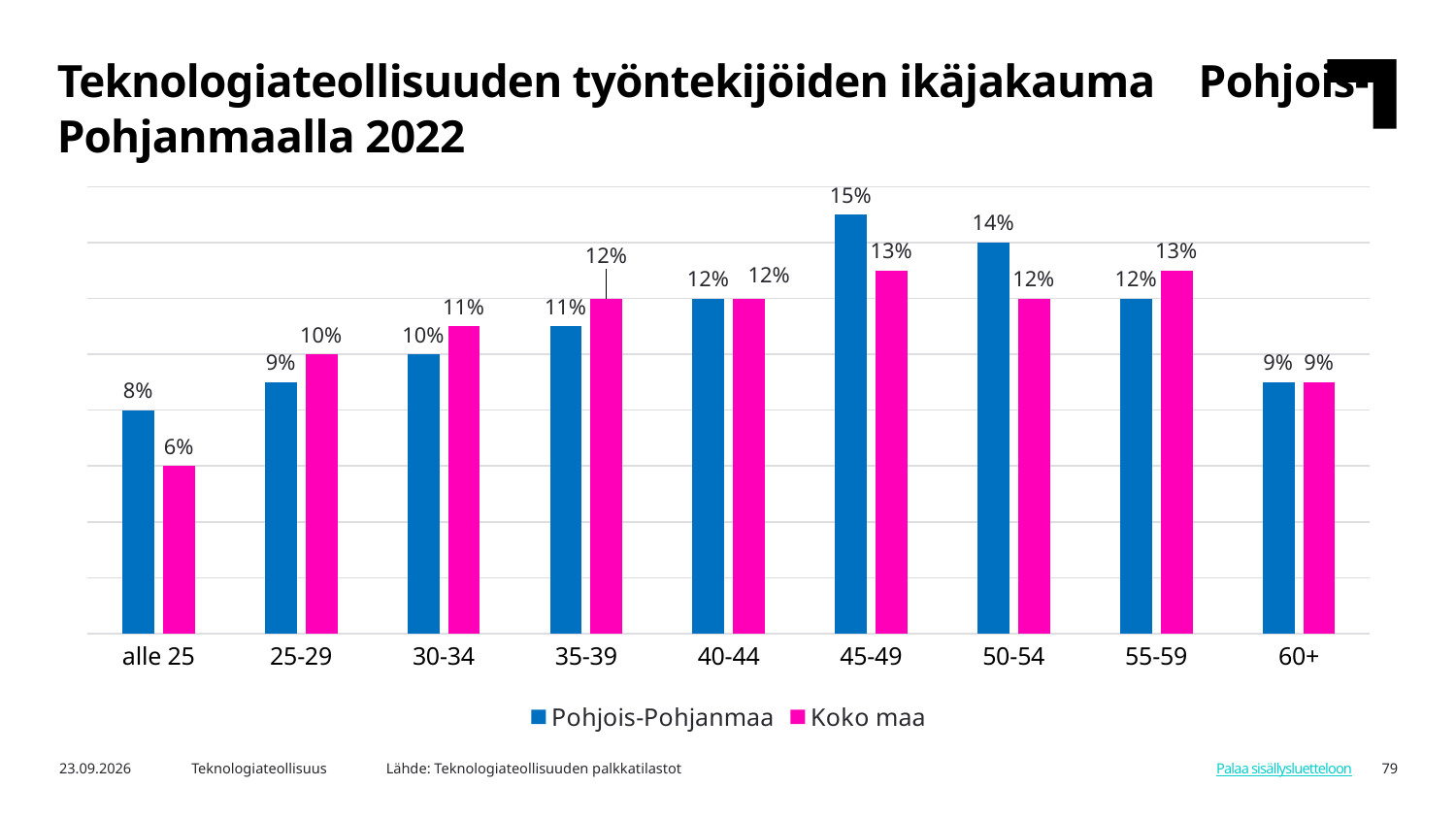
Which age group has the highest value for Pohjois-Pohjanmaa? 45-49 Which age group has the lowest value for Koko maa? alle 25 What is the value for Pohjois-Pohjanmaa in the 45-49 age group? 15% Which colour represents Koko maa in the chart? Pink What is the difference between Pohjois-Pohjanmaa and Koko maa in the 45-49 age group? 2% What is the value for Koko maa in the alle 25 age group? 6% How many age groups are shown on the x axis? 9 What is the value for Koko maa in the 55-59 age group? 13% Which is larger in the 50-54 age group, Pohjois-Pohjanmaa or Koko maa? Pohjois-Pohjanmaa How many series does the legend list? 2 What kind of chart is shown on the slide? Bar chart Which is larger in the 25-29 age group, Pohjois-Pohjanmaa or Koko maa? Koko maa